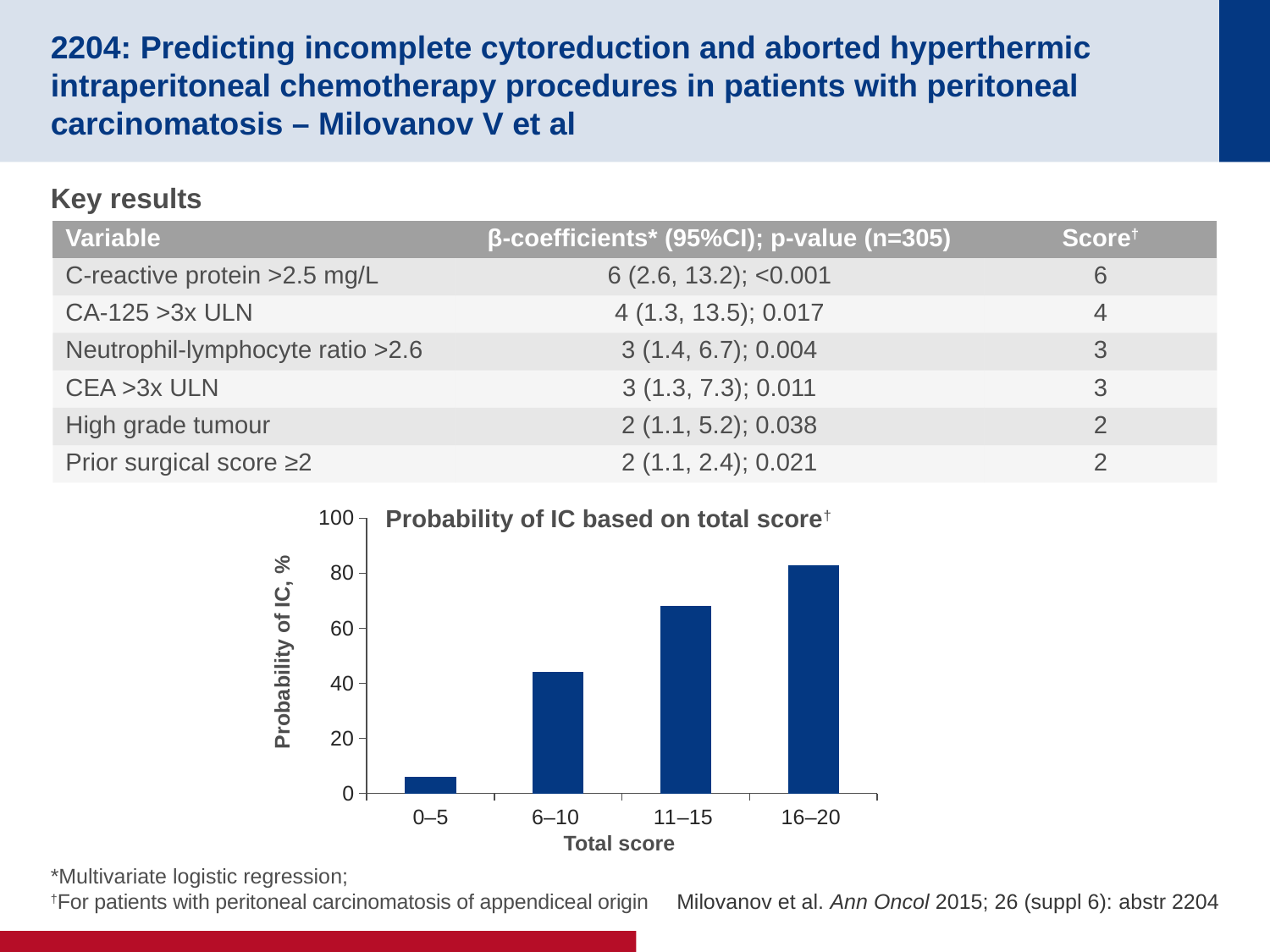
Is the probability of IC for the total score 6–10 greater or less than 60? less Does the probability of IC rise or fall as the total score increases along the x axis? rise Which total score category has the highest probability of IC in the chart? 16–20 What is the label of the x axis of the chart? Total score Which has a higher probability of IC: total score 6–10 or total score 11–15? 11–15 What is the label of the y axis of the chart? Probability of IC, % What kind of chart is shown under the title "Probability of IC based on total score"? bar chart Is the probability of IC for the total score 16–20 greater or less than 60? greater How many total score categories are plotted on the x axis of the chart? 4 Is the probability of IC for the total score 0–5 greater or less than 20? less Which total score category has the lowest probability of IC in the chart? 0–5